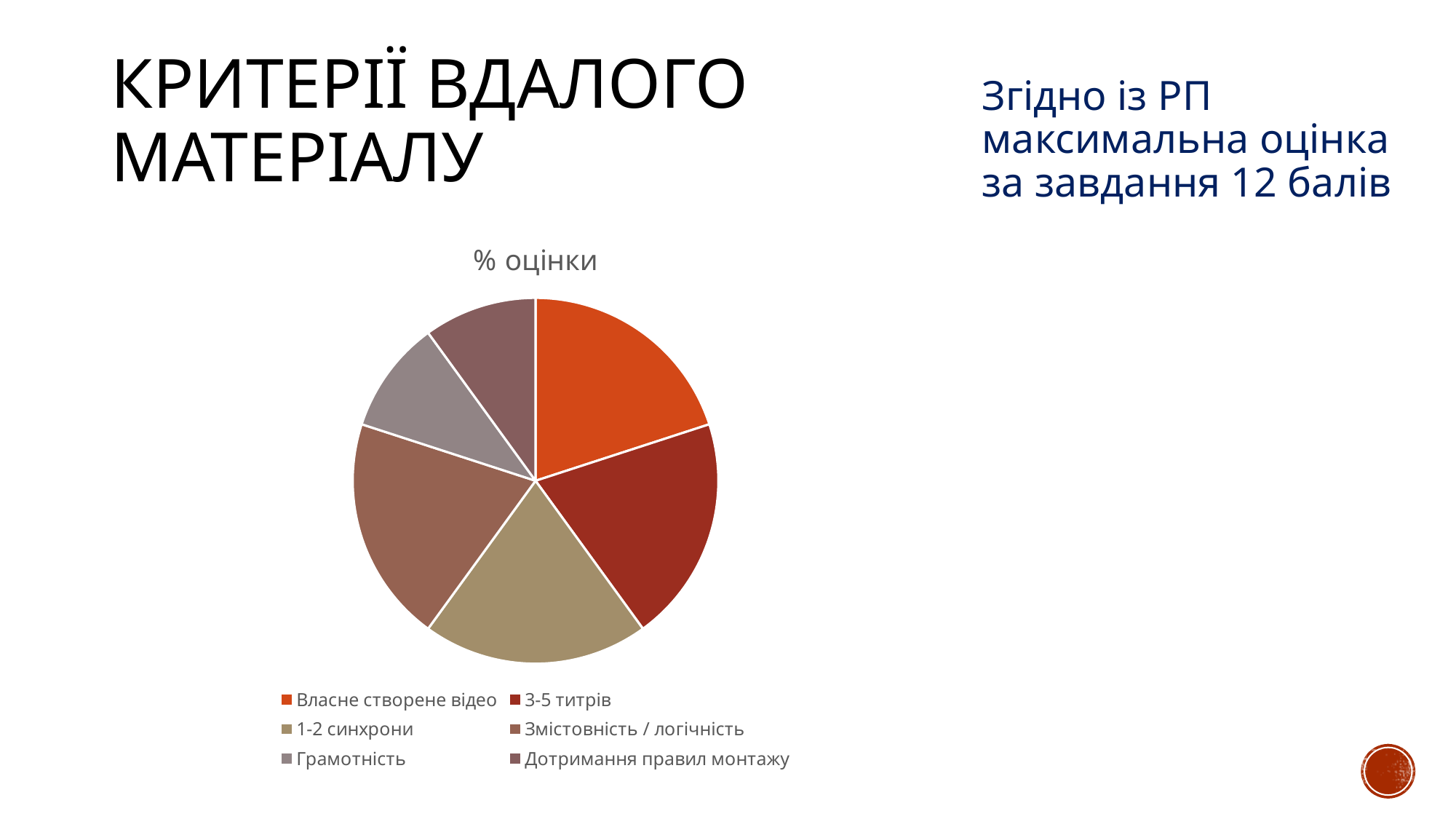
Which slice is larger: 3-5 титрів or Дотримання правил монтажу? 3-5 титрів Which slice is smaller: Грамотність or 1-2 синхрони? Грамотність What kind of chart is shown on the slide? pie chart How many entries does the legend of the pie chart list? 6 What is the title of the pie chart? % оцінки Which slice is larger: Власне створене відео or Грамотність? Власне створене відео How many slices does the pie chart have? 6 Which legend entry is shown in orange in the pie chart? Власне створене відео